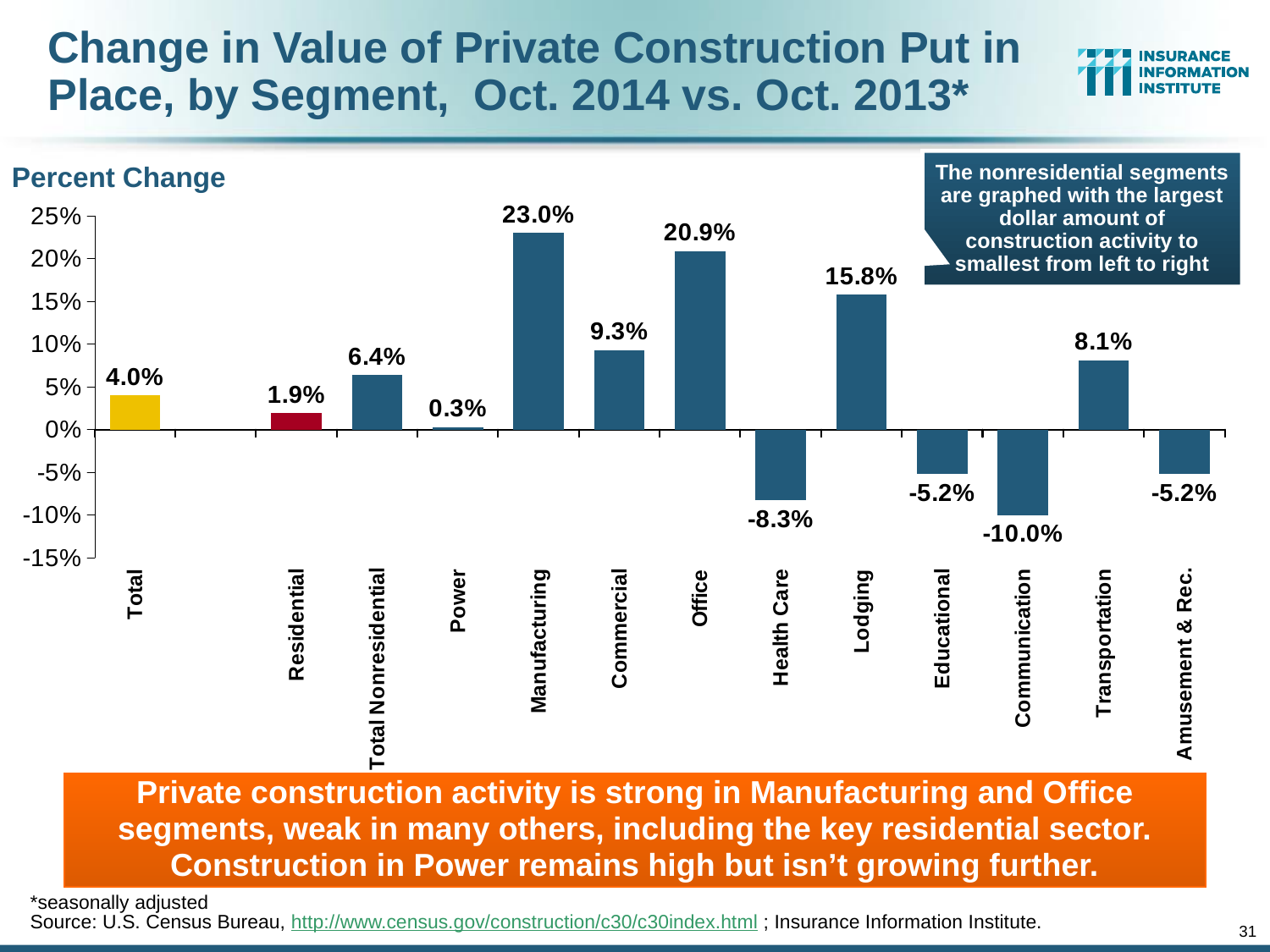
What is the difference between the percent change for Office and the percent change for Lodging? 5.1% What is the label on the vertical axis of the chart? Percent Change Which segment has the highest percent change? Manufacturing What is the difference between the percent change for Total Nonresidential and the percent change for Total? 2.4% Which has a larger percent change, Commercial or Transportation? Commercial What is the percent change for Residential? 1.9% Which segment has the lowest percent change? Communication What is the percent change for Communication? -10.0% What is the percent change for Health Care? -8.3% What is the percent change for Manufacturing? 23.0% What kind of chart is shown on the slide? Bar chart How many segments are shown on the chart? 13